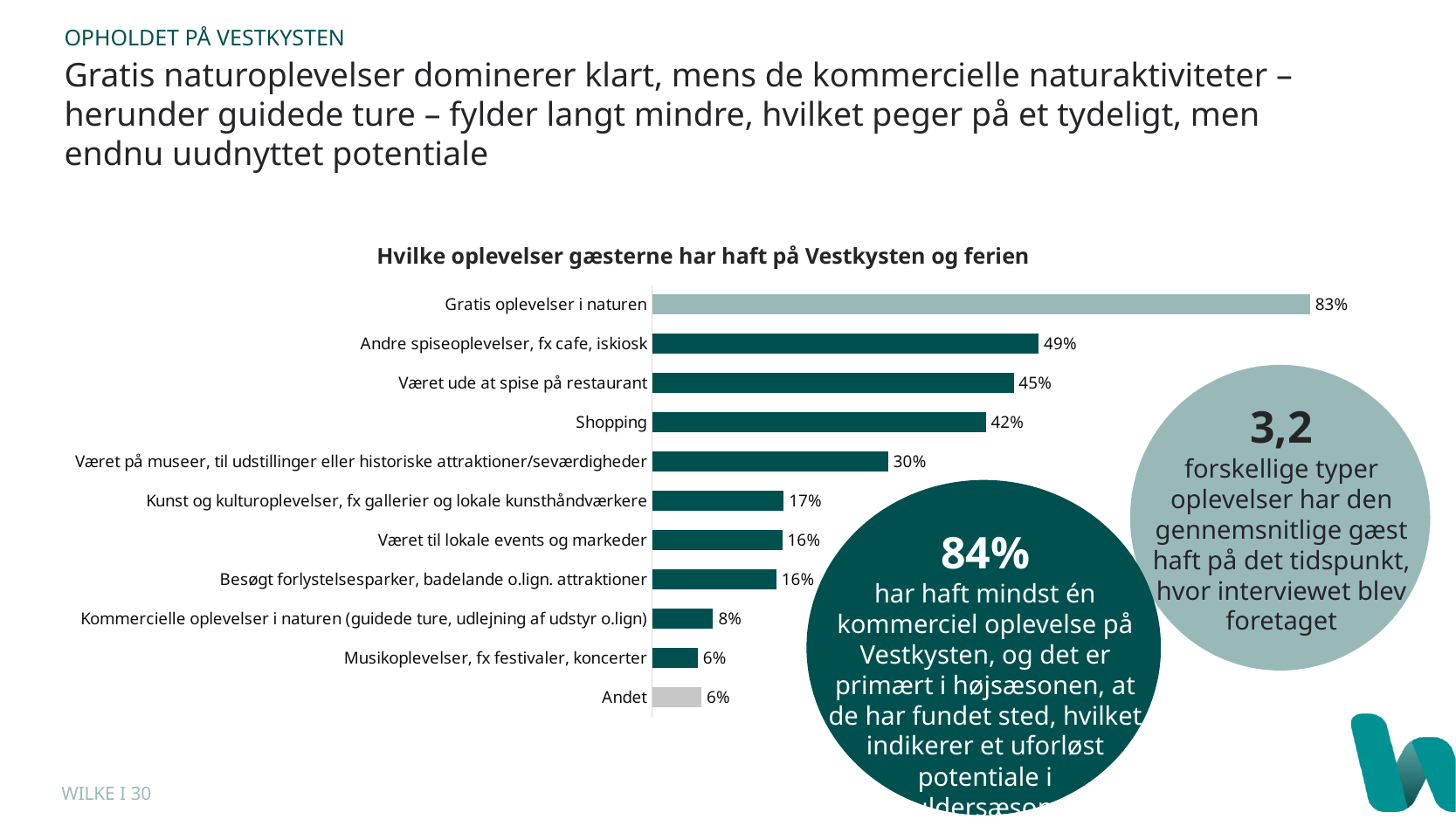
What kind of chart is shown? Bar chart Which category has the highest value? Gratis oplevelser i naturen What is the difference between "Gratis oplevelser i naturen" and "Andre spiseoplevelser, fx cafe, iskiosk"? 34 percentage points Which is larger: "Andre spiseoplevelser, fx cafe, iskiosk" or "Været ude at spise på restaurant"? Andre spiseoplevelser, fx cafe, iskiosk What is the value for "Været på museer, til udstillinger eller historiske attraktioner/seværdigheder"? 30% What is the value for "Kommercielle oplevelser i naturen (guidede ture, udlejning af udstyr o.lign)"? 8% What is the value for "Gratis oplevelser i naturen"? 83% What is the title of the chart? Hvilke oplevelser gæsterne har haft på Vestkysten og ferien Which is larger: "Kunst og kulturoplevelser, fx gallerier og lokale kunsthåndværkere" or "Kommercielle oplevelser i naturen (guidede ture, udlejning af udstyr o.lign)"? Kunst og kulturoplevelser, fx gallerier og lokale kunsthåndværkere What is the difference between "Været ude at spise på restaurant" and "Shopping"? 3 percentage points What is the value for "Shopping"? 42% How many categories are shown in the chart? 11